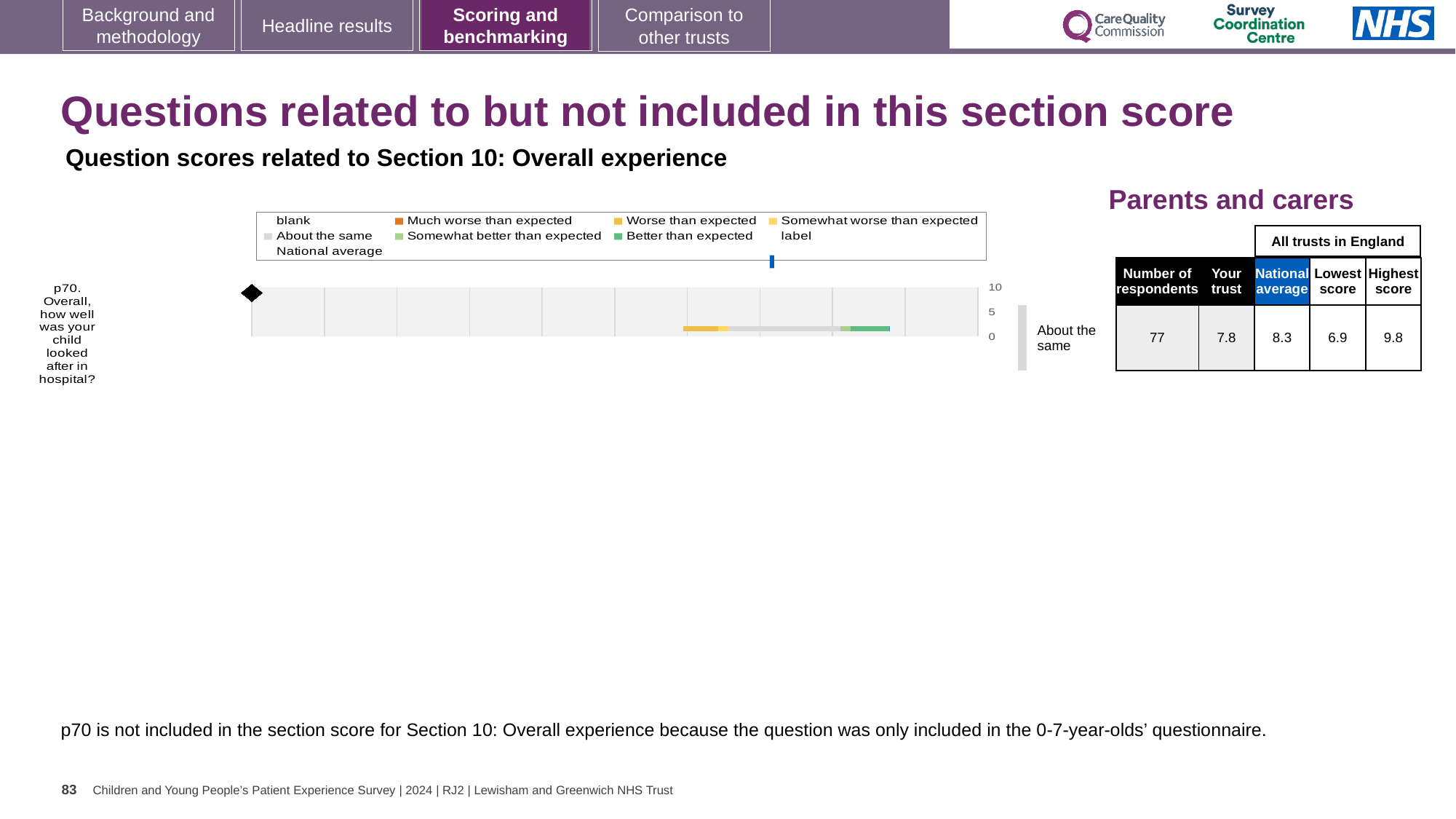
What is the 'Your trust' score for p70 in the Parents and carers table? 7.8 How many respondents answered question p70? 77 What category label is shown to the right of the p70 bar? About the same What is the national average score for p70? 8.3 How many survey questions are plotted in the chart? 1 What is the lowest score among all trusts in England for p70? 6.9 What is the full text of the question plotted in the chart? p70. Overall, how well was your child looked after in hospital? Is the 'Your trust' score for p70 greater or less than 5? greater What is the highest score among all trusts in England for p70? 9.8 Which is larger for p70: the 'Your trust' score or the national average? National average What kind of chart is shown for question p70? bar chart What is the difference between the highest score and the lowest score for p70? 2.9